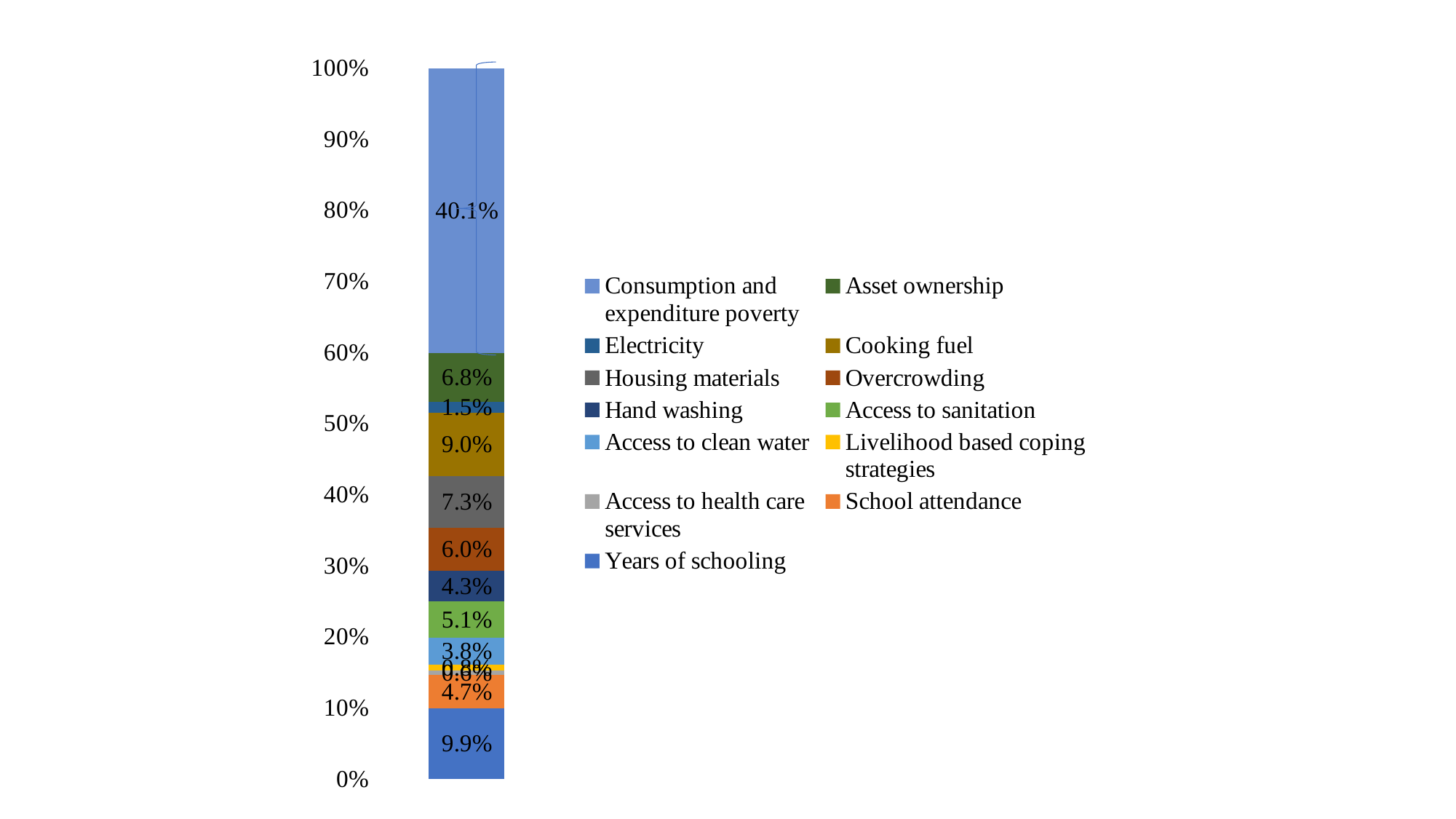
What colour is the Cooking fuel segment in the stacked bar? Dark yellow (gold) Which is larger, the value for Hand washing or the value for Access to sanitation? Access to sanitation What is the value for Cooking fuel? 9.0% What is the difference between the Cooking fuel value and the Housing materials value? 1.7% Which series has the largest segment in the stacked bar? Consumption and expenditure poverty What is the value for Years of schooling? 9.9% What is the value for Consumption and expenditure poverty in the stacked bar? 40.1% How many series does the legend list? 13 What is the value for Housing materials? 7.3% What is the value for Electricity? 1.5% What kind of chart is shown on the slide? Stacked bar chart Which is larger, the value for Asset ownership or the value for Overcrowding? Asset ownership